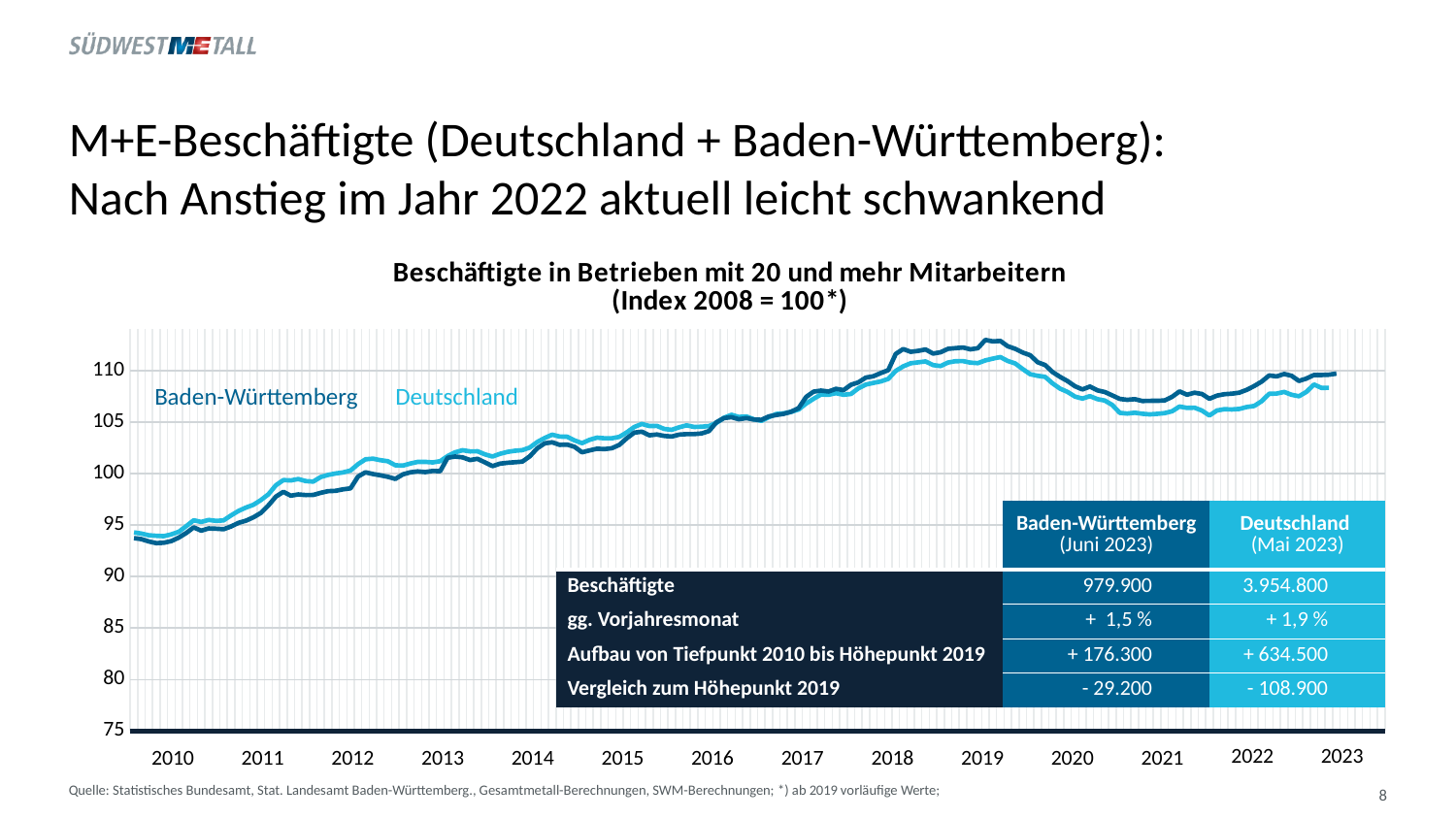
What kind of chart is shown on the slide? line chart Which series is higher at the 2019 peak, Baden-Württemberg or Deutschland? Baden-Württemberg Is the value for Deutschland in 2021 greater or less than 100? greater How many year labels are shown on the x axis? 14 How many series does the chart's legend list? 2 Do the index values for Baden-Württemberg rise or fall between 2010 and 2019? rise Is the value for Baden-Württemberg at its 2019 peak greater or less than 110? greater Which series is higher in 2012, Baden-Württemberg or Deutschland? Deutschland According to the table on the chart, how many Beschäftigte does Baden-Württemberg have in Juni 2023? 979.900 Which two series are shown in the chart? Baden-Württemberg and Deutschland What is the title of the chart? Beschäftigte in Betrieben mit 20 und mehr Mitarbeitern (Index 2008 = 100*) Is the value for Baden-Württemberg at the start of 2010 greater or less than 95? less